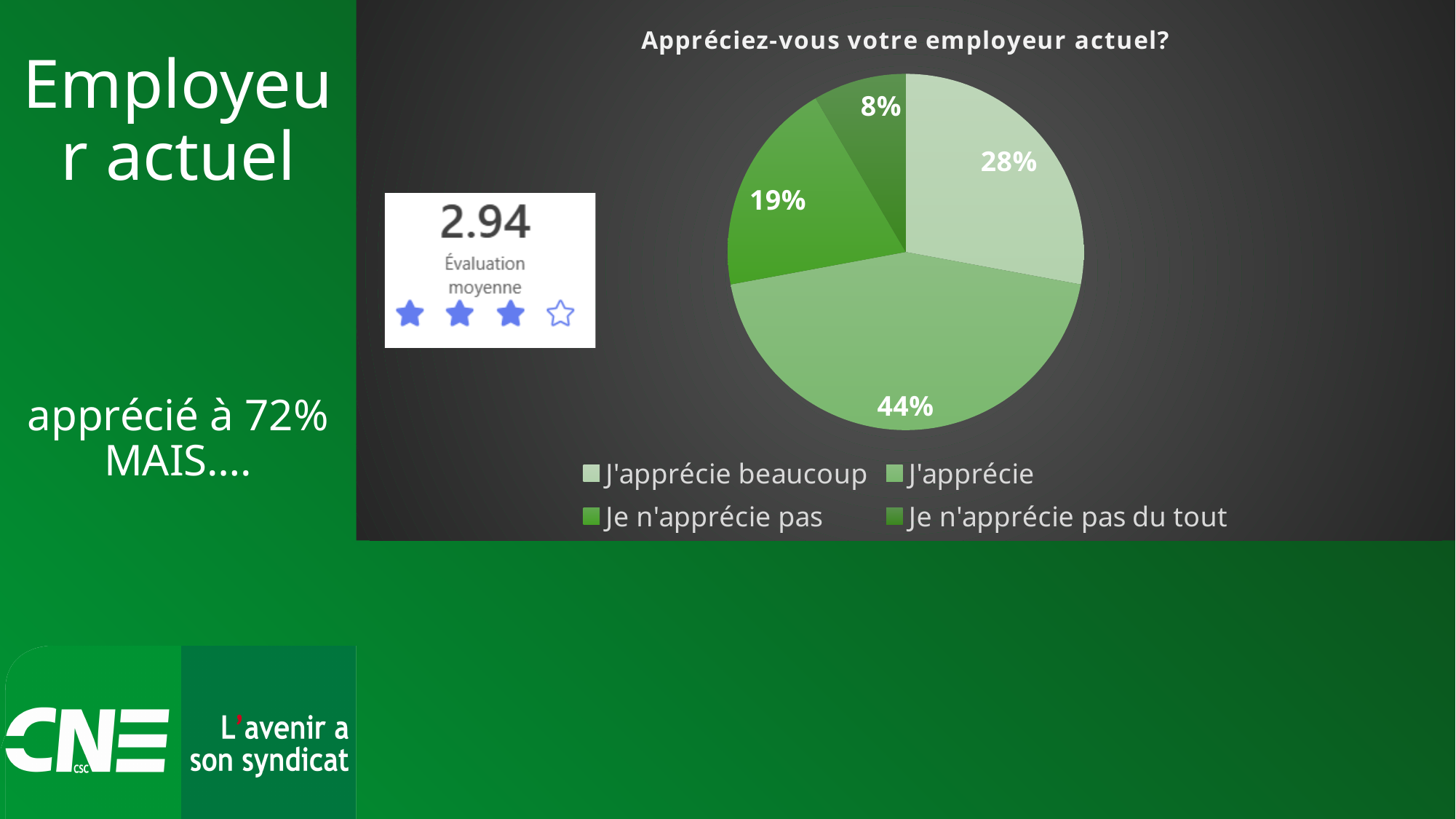
What percentage of the pie corresponds to "Je n'apprécie pas du tout"? 8% Which category has the smallest slice of the pie? Je n'apprécie pas du tout Which category has the largest slice of the pie? J'apprécie What kind of chart is shown on the slide? Pie chart How many categories does the legend of the pie chart list? 4 What percentage of the pie corresponds to "J'apprécie beaucoup"? 28% What is the title of the chart? Appréciez-vous votre employeur actuel? Which is larger: the slice for "Je n'apprécie pas" or the slice for "J'apprécie beaucoup"? J'apprécie beaucoup What percentage of the pie corresponds to "J'apprécie"? 44% What is the combined share of "J'apprécie beaucoup" and "J'apprécie"? 72% What is the difference in percentage points between "J'apprécie" and "J'apprécie beaucoup"? 16 What percentage of the pie corresponds to "Je n'apprécie pas"? 19%